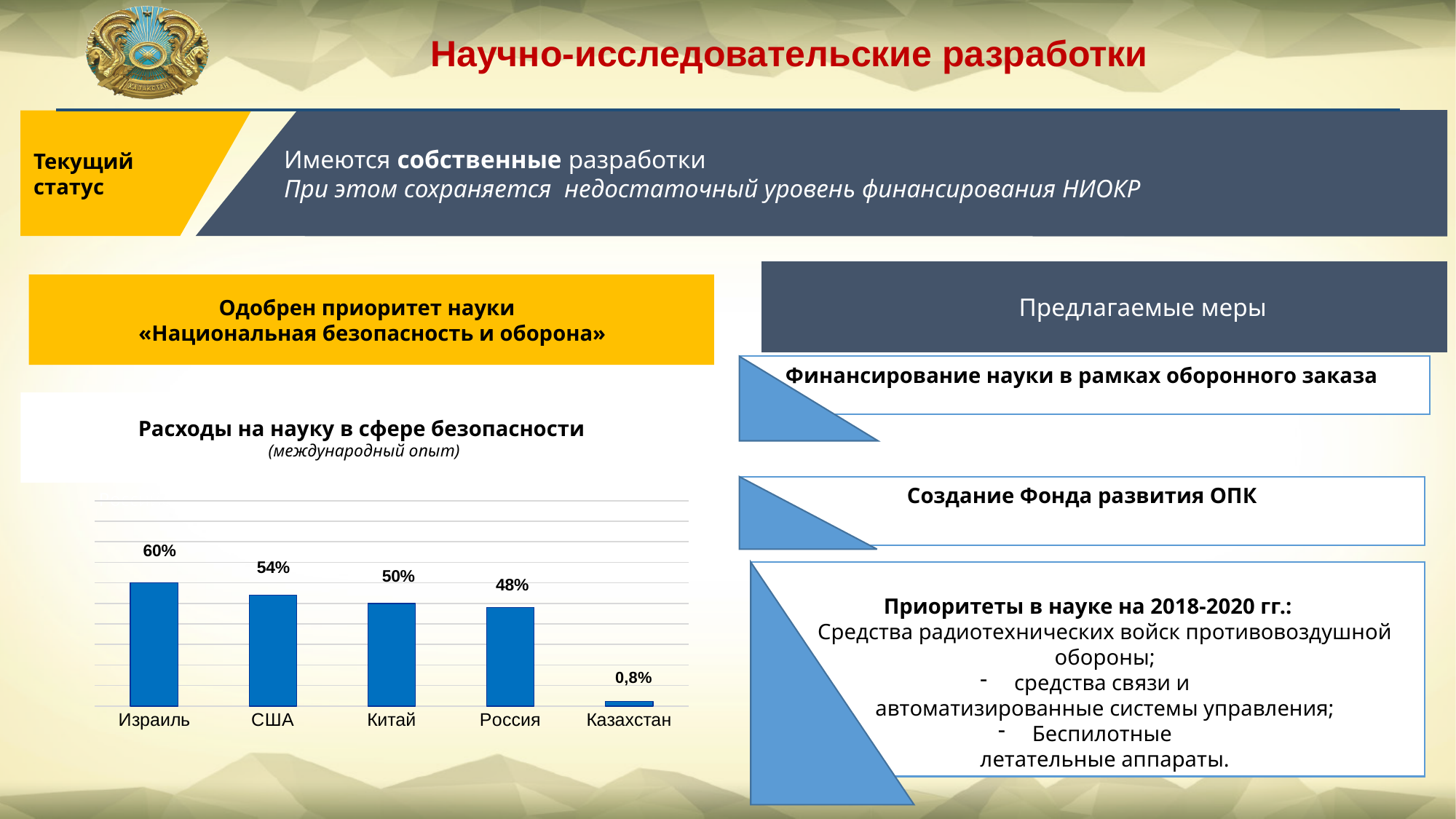
Which country has the lowest value in the chart? Казахстан Which country has the highest value in the chart? Израиль What is the title of the chart on the slide? Расходы на науку в сфере безопасности (международный опыт) Which is larger, the value for США or the value for Россия? США What kind of chart is shown on the slide? Bar chart What is the difference between the values for Израиль and США? 6% What is the value for Казахстан in the chart? 0,8% What is the value for Израиль in the chart? 60% How many countries are shown in the chart? 5 What is the difference between the values for Китай and Россия? 2% What is the value for Китай in the chart? 50% What is the value for Россия in the chart? 48%